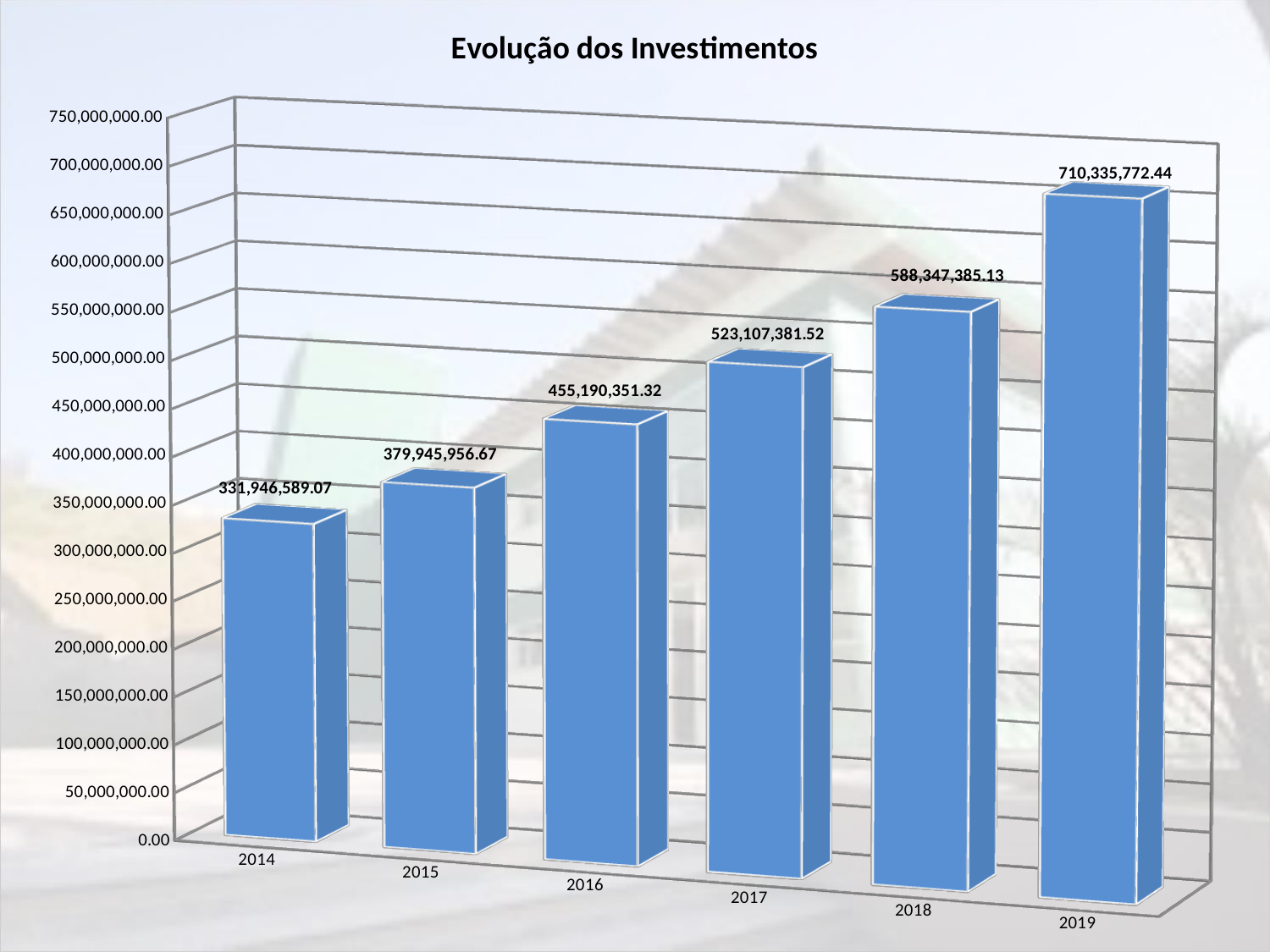
What is the value for 2019? 710,335,772.44 Which year has the lowest value? 2014 What is the value for 2016? 455,190,351.32 What is the difference between the values for 2015 and 2014? 47,999,367.60 What is the value for 2014? 331,946,589.07 What is the difference between the values for 2019 and 2018? 121,988,387.31 What kind of chart is this? bar chart How many years are shown on the x axis? 6 Is the value for 2017 greater or less than 500,000,000.00? greater Which year has the highest value? 2019 Do the values rise or fall from 2014 to 2019? rise Which is larger, the value for 2017 or the value for 2018? 2018